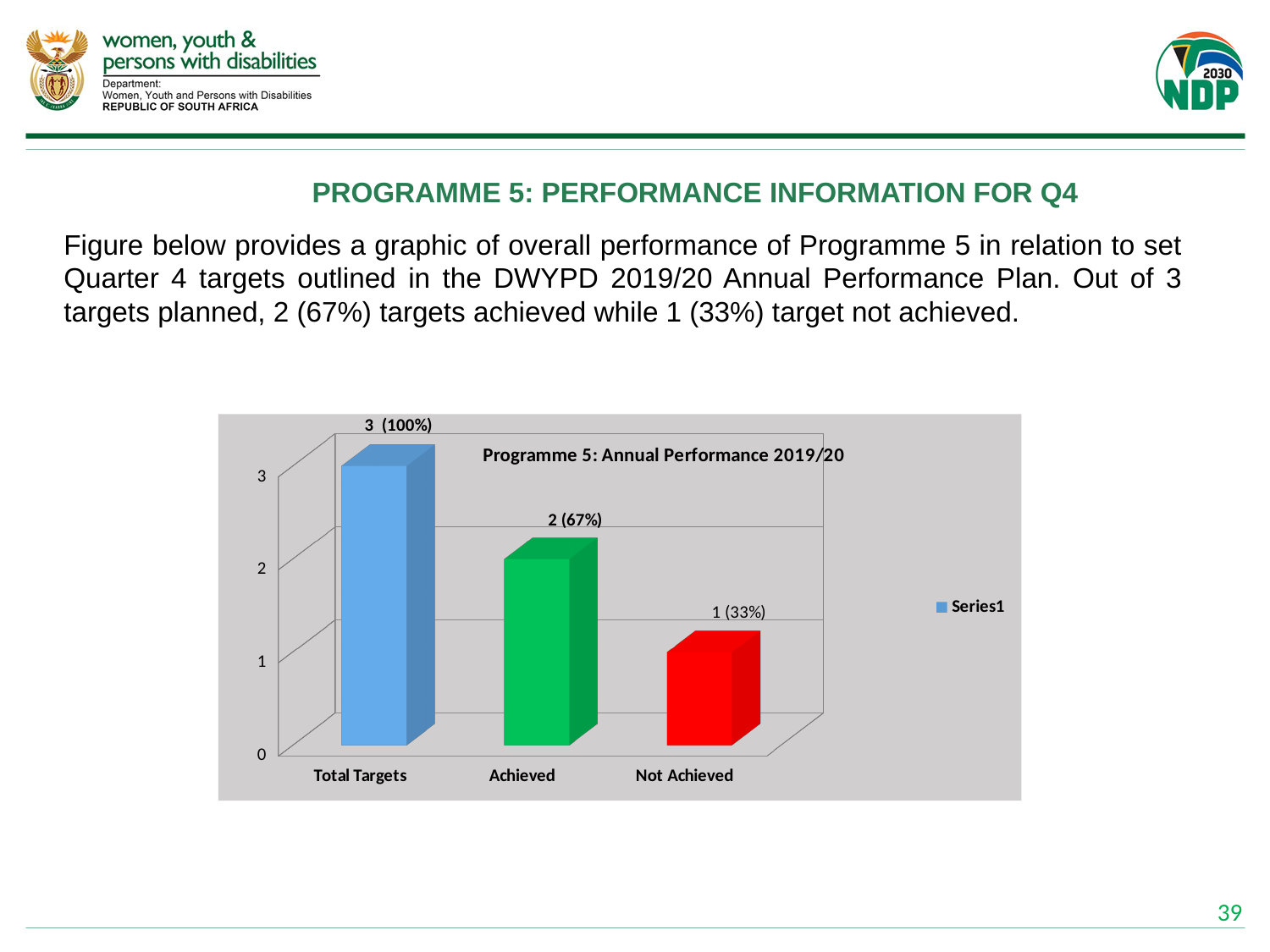
Do the bar values rise or fall from left to right along the x axis? Fall Which category has the highest bar? Total Targets What is the title of the chart? Programme 5: Annual Performance 2019/20 How many categories are shown on the x axis? 3 Which is larger, the value for Achieved or the value for Not Achieved? Achieved What is the value shown for Not Achieved? 1 (33%) What is the difference between the number of targets Achieved and Not Achieved? 1 What kind of chart is shown? Bar chart Which category has the lowest bar? Not Achieved What is the value shown for Achieved? 2 (67%) How many series does the legend list? 1 What is the value shown for Total Targets? 3 (100%)